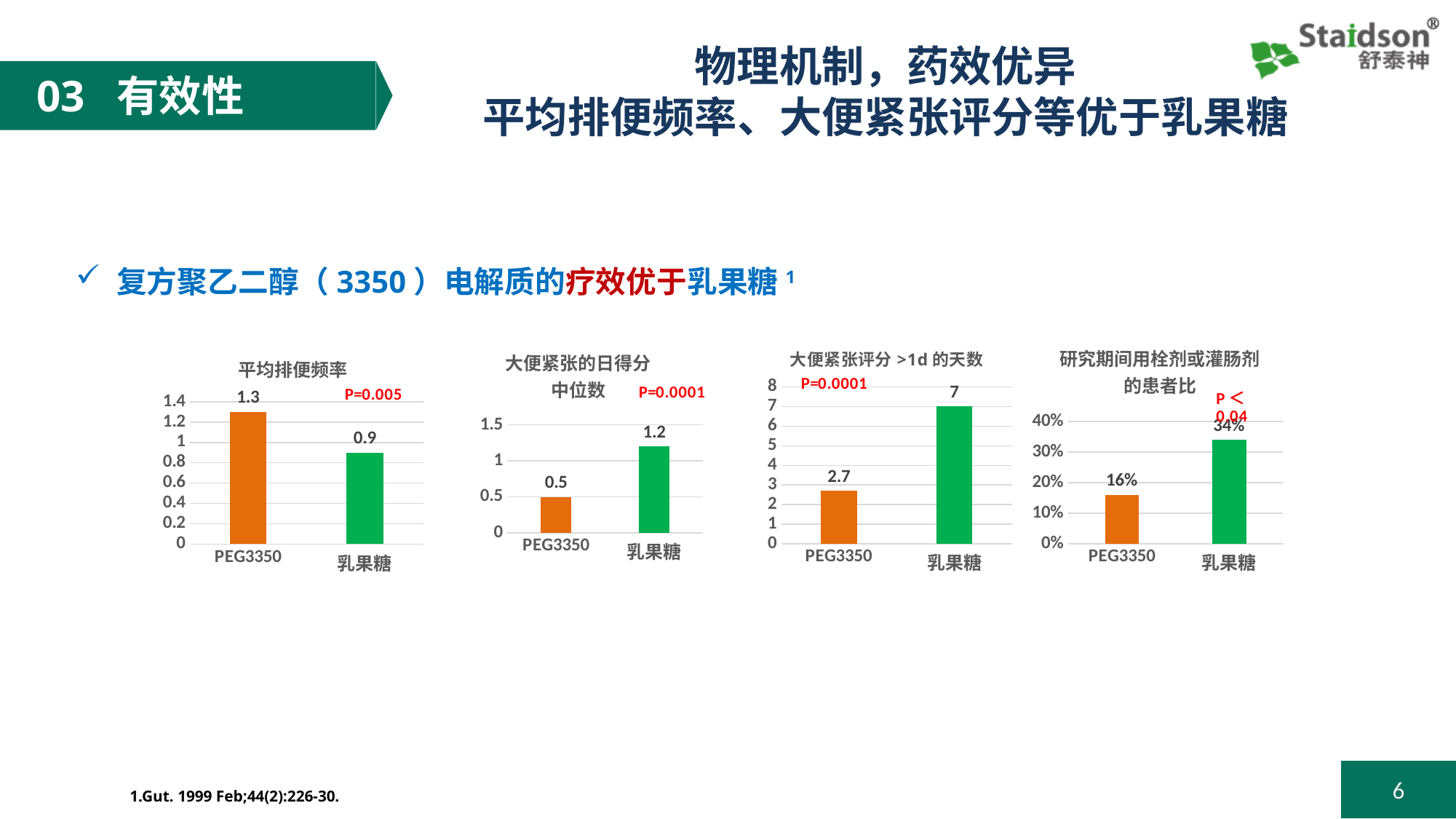
In the chart titled 平均排便频率, what is the difference between the PEG3350 and 乳果糖 values? 0.4 In the chart titled 研究期间用栓剂或灌肠剂的患者比, what is the value for PEG3350? 16% How many categories are shown in the chart titled 大便紧张评分 >1d 的天数? 2 In the chart titled 大便紧张评分 >1d 的天数, what is the difference between the 乳果糖 and PEG3350 values? 4.3 In the chart titled 平均排便频率, what is the value for PEG3350? 1.3 In the chart titled 研究期间用栓剂或灌肠剂的患者比, what is the value for 乳果糖? 34% In the chart titled 平均排便频率, what is the value for 乳果糖? 0.9 In the chart titled 大便紧张的日得分中位数, what is the value for PEG3350? 0.5 What kind of chart is the chart titled 平均排便频率? Bar chart In the chart titled 大便紧张的日得分中位数, which category has the higher value? 乳果糖 In the chart titled 研究期间用栓剂或灌肠剂的患者比, which category has the lower value? PEG3350 In the chart titled 大便紧张评分 >1d 的天数, what is the value for 乳果糖? 7